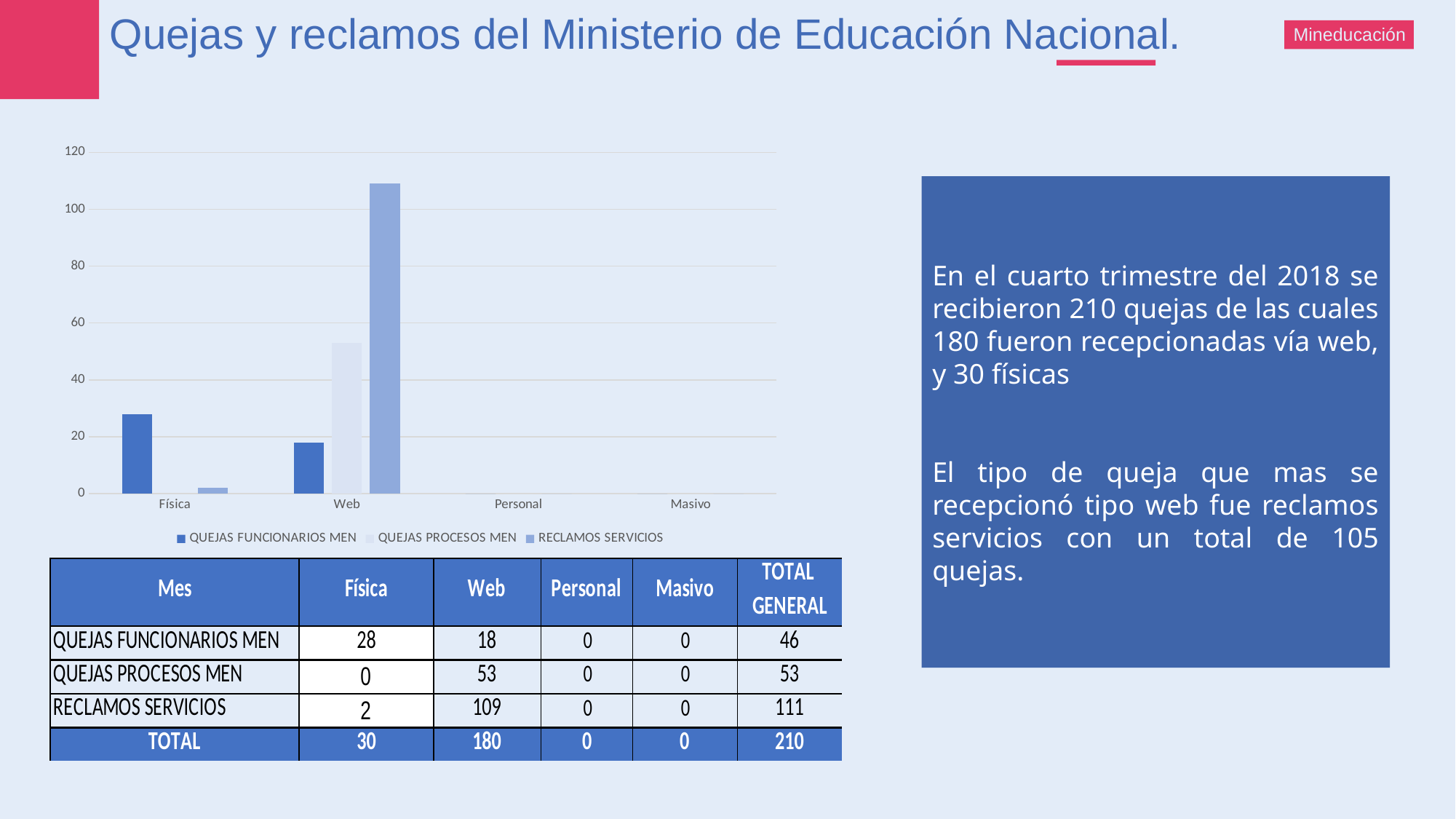
How many series does the chart legend list? 3 Is the value for RECLAMOS SERVICIOS in the Web category greater or less than 100? greater What kind of chart is shown on the slide? bar chart How many categories are shown on the x axis of the chart? 4 Is the value for QUEJAS FUNCIONARIOS MEN in the Física category greater or less than 20? greater In the Física category, which is larger: QUEJAS FUNCIONARIOS MEN or RECLAMOS SERVICIOS? QUEJAS FUNCIONARIOS MEN Using the values in the table, what is the difference between RECLAMOS SERVICIOS and QUEJAS PROCESOS MEN in the Web category? 56 Is the value for QUEJAS PROCESOS MEN in the Web category greater or less than 60? less In which category does the RECLAMOS SERVICIOS series reach its highest value? Web According to the table below the chart, what is the value for RECLAMOS SERVICIOS in the Web category? 109 What is the first series listed in the chart legend? QUEJAS FUNCIONARIOS MEN According to the table below the chart, what is the value for QUEJAS FUNCIONARIOS MEN in the Física category? 28